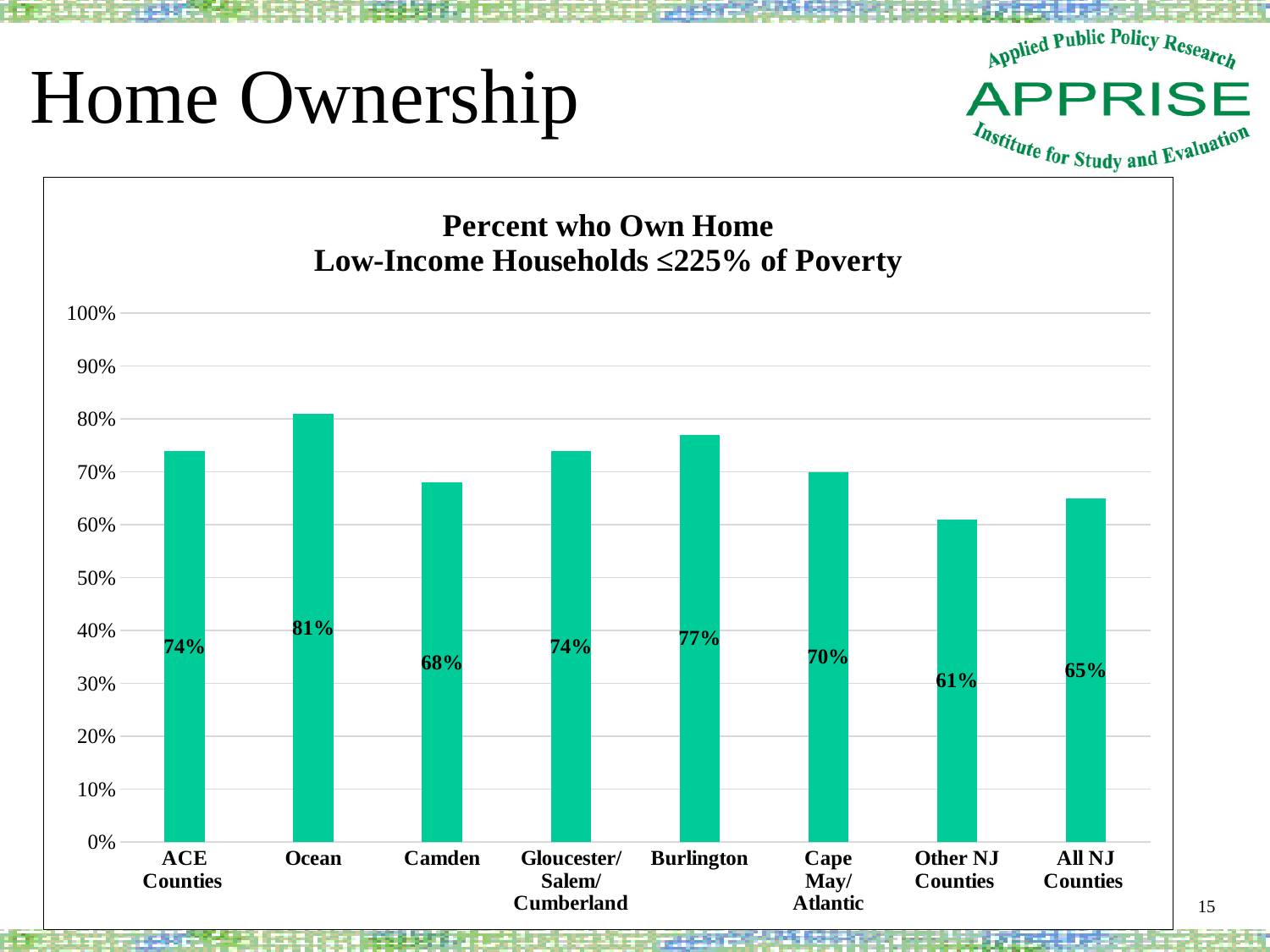
What percent of low-income households in Ocean own their home? 81% Which is larger, the value for Burlington or the value for Cape May/Atlantic? Burlington What kind of chart is shown on the slide? Bar chart Which category has the lowest percent who own their home? Other NJ Counties What is the value for All NJ Counties? 65% What is the title of the chart? Percent who Own Home Low-Income Households ≤225% of Poverty What is the value for Cape May/Atlantic? 70% What is the value for Other NJ Counties? 61% What is the difference between the values for Ocean and Camden? 13% How many categories are shown on the x axis? 8 What is the difference between the values for Burlington and All NJ Counties? 12% Which category has the highest percent who own their home? Ocean